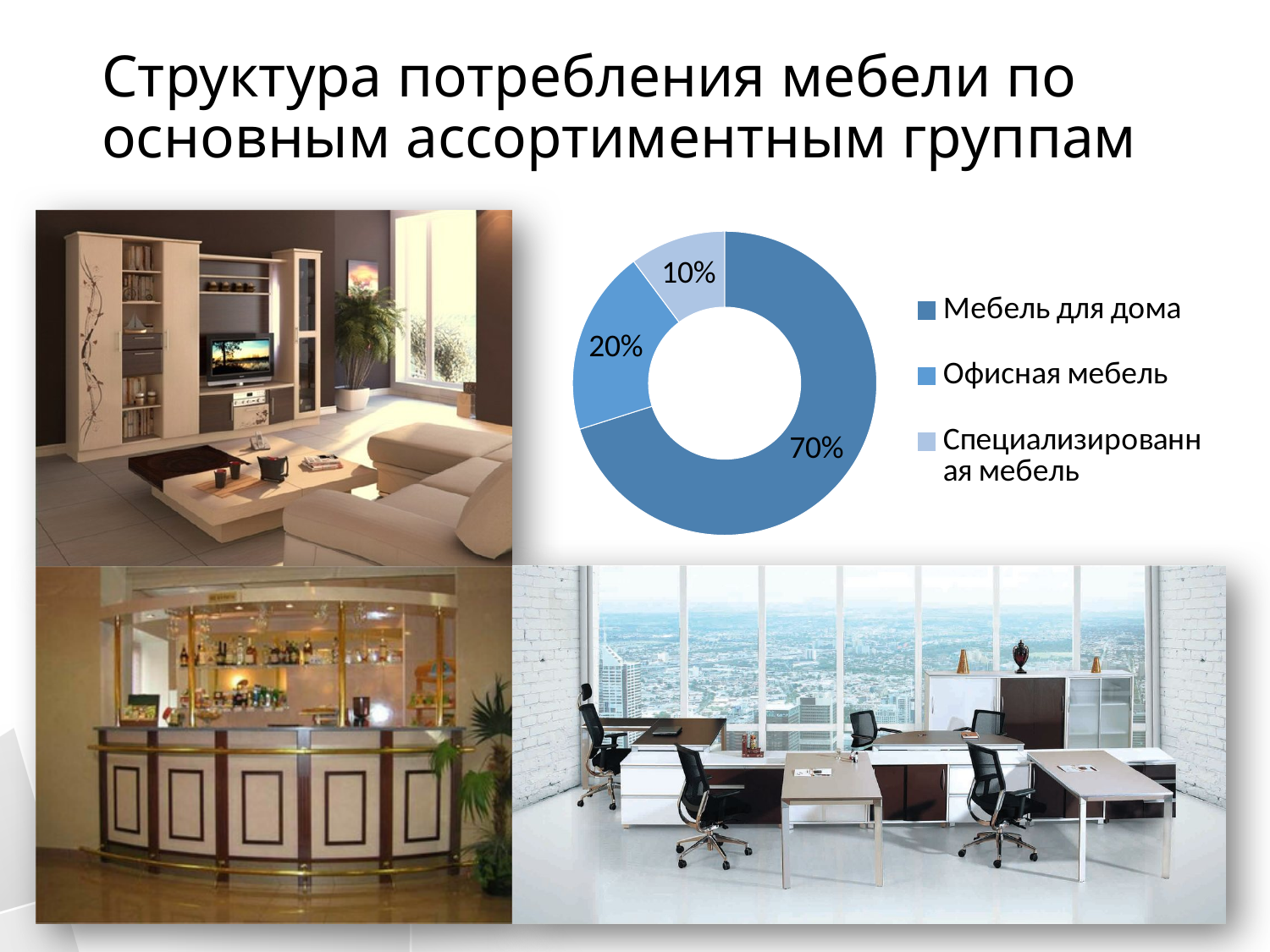
Which is larger: the share of Офисная мебель or the share of Специализированная мебель? Офисная мебель Which category has the smallest share in the chart? Специализированная мебель By how many percentage points does Мебель для дома exceed Офисная мебель? 50 percentage points Which category has the largest share in the chart? Мебель для дома What is the difference between the shares of Офисная мебель and Специализированная мебель? 10 percentage points What is the combined share of Офисная мебель and Специализированная мебель? 30% What percentage is shown for Специализированная мебель? 10% What share of furniture consumption does Мебель для дома account for? 70% What is the title of the slide containing the chart? Структура потребления мебели по основным ассортиментным группам What type of chart is shown on the slide? Doughnut (pie) chart How many categories are shown in the chart? 3 What percentage is shown for Офисная мебель? 20%